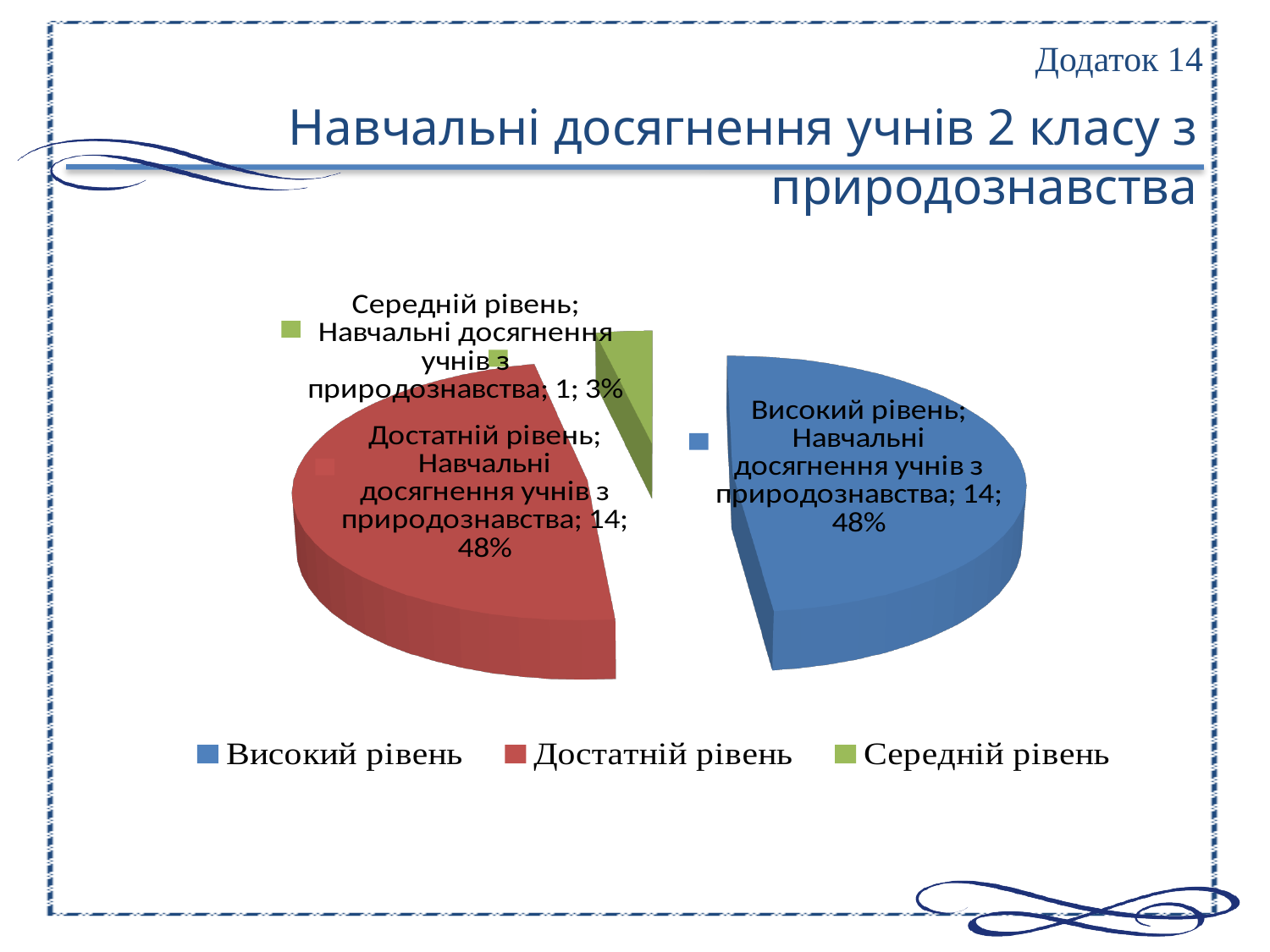
What share of the pie does Високий рівень represent? 48% How many entries does the legend list? 3 What is the value for Достатній рівень? 14 What is the value for Середній рівень? 1 What is the value for Високий рівень? 14 What share of the pie does Середній рівень represent? 3% What colour is the slice for Середній рівень? green What is the difference between the values for Високий рівень and Середній рівень? 13 Which category has the smallest slice? Середній рівень What kind of chart is shown on the slide? pie chart How many slices does the pie chart have? 3 Which is larger, the value for Достатній рівень or the value for Середній рівень? Достатній рівень